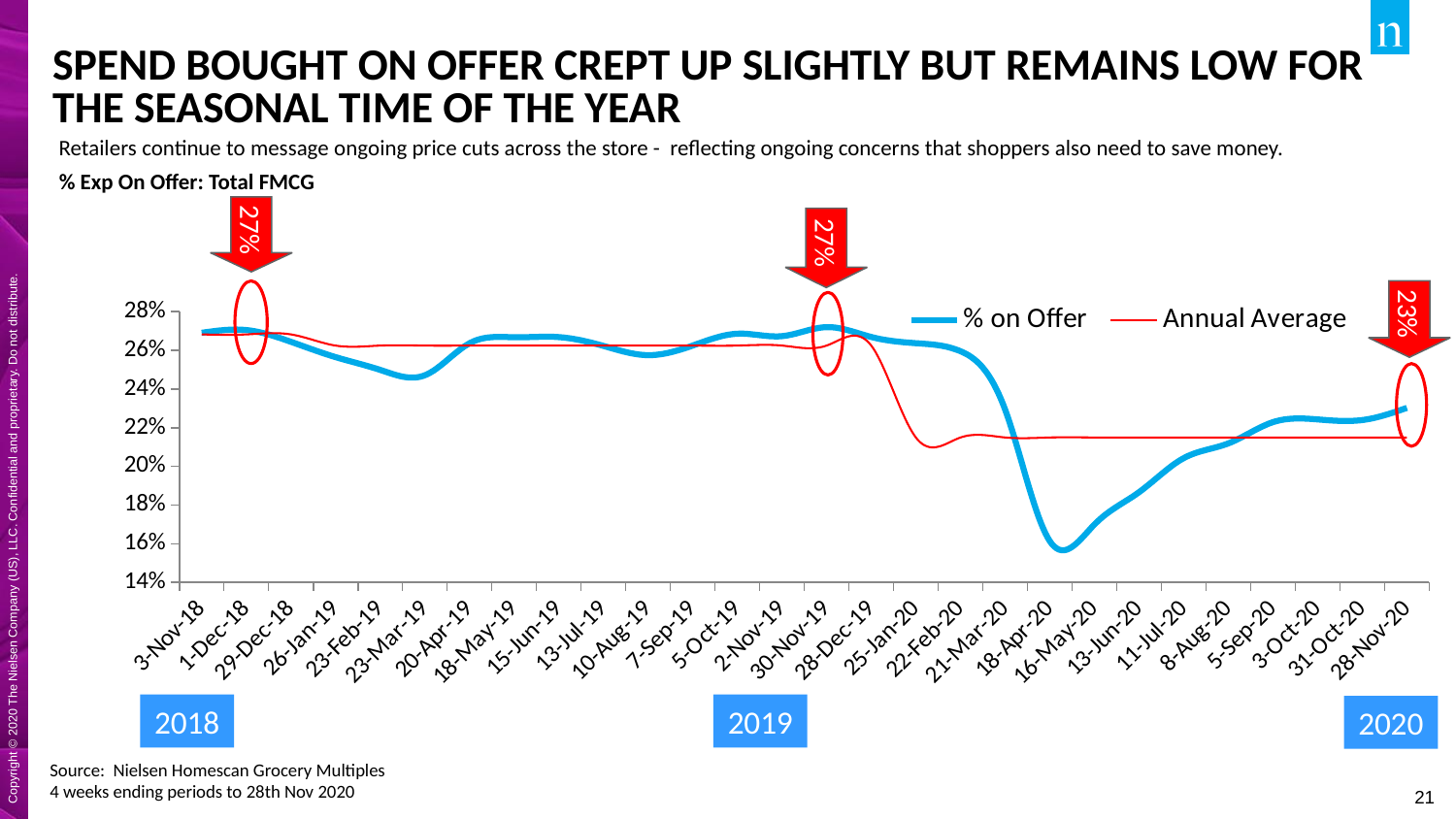
What kind of chart is shown on the slide? Line chart How many series does the legend list? 2 What is the % on Offer value highlighted for 1-Dec-18? 27% By how many percentage points is the highlighted % on Offer value for 28-Nov-20 lower than the highlighted value for 30-Nov-19? 4 percentage points Which has the larger highlighted % on Offer value, 1-Dec-18 or 28-Nov-20? 1-Dec-18 At which date does the % on Offer line reach its lowest point? 18-Apr-20 Does the % on Offer line rise or fall between 16-May-20 and 28-Nov-20? Rise What is the title of the chart? % Exp On Offer: Total FMCG What is the % on Offer value highlighted for 30-Nov-19? 27% What is the % on Offer value highlighted for 28-Nov-20? 23% Is the Annual Average value for 18-Apr-20 greater or less than 24%? less Is the % on Offer value for 16-May-20 greater or less than 18%? less